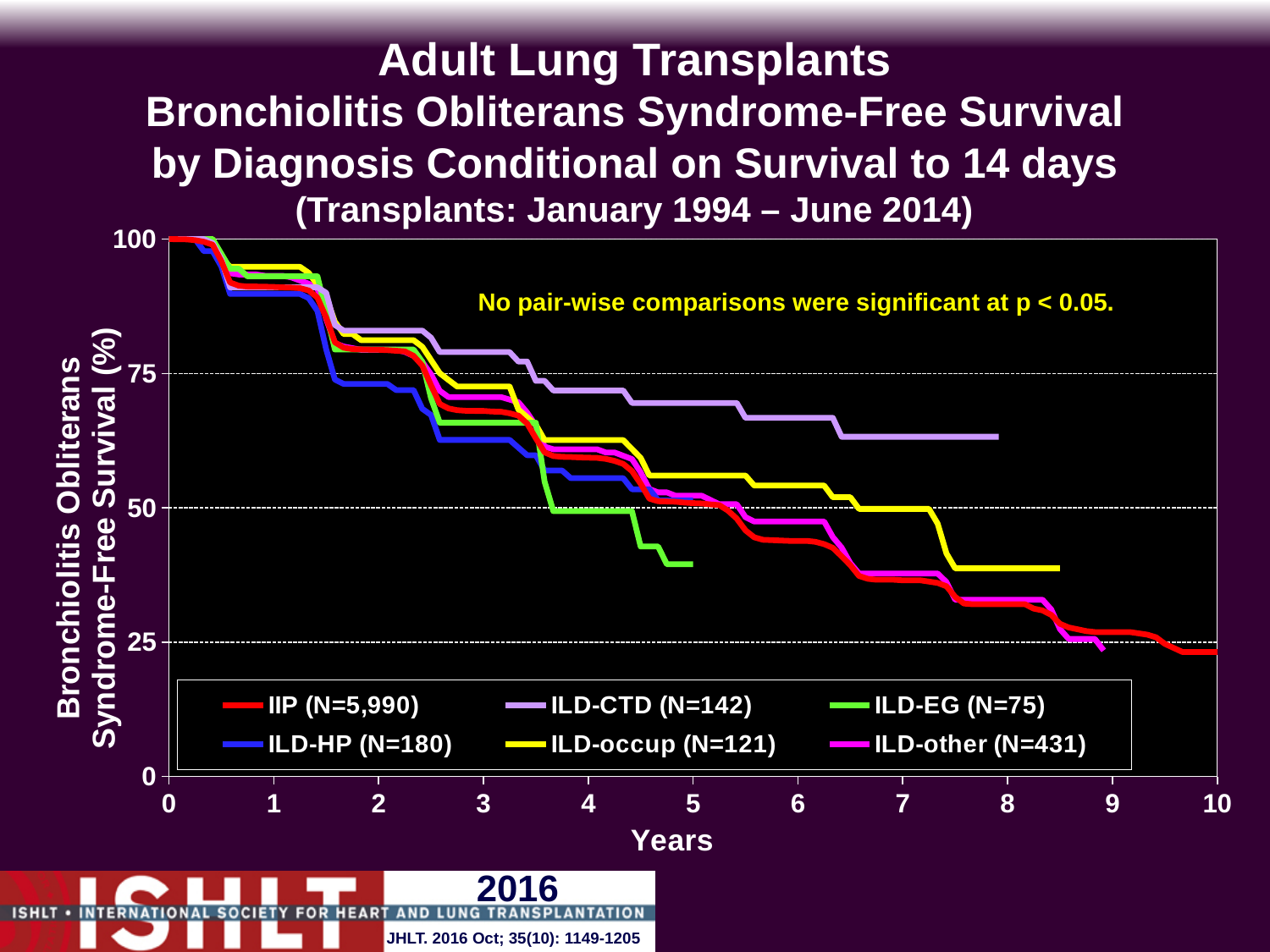
Is the value for ILD-CTD at 7 years greater or less than 50? greater Is the value for ILD-EG at 5 years greater or less than 50? less At 7 years, which series has the higher BOS-free survival, ILD-CTD or IIP? ILD-CTD What kind of chart is shown on the slide? line chart Is the value for ILD-CTD at 2 years greater or less than 75? greater Which series has the highest BOS-free survival at 7 years? ILD-CTD How many series does the legend list? 6 Do the survival curves rise or fall as years increase along the x axis? fall Which series is the only one whose curve extends to 10 years? IIP What is the sample size (N) shown in the legend for IIP? 5,990